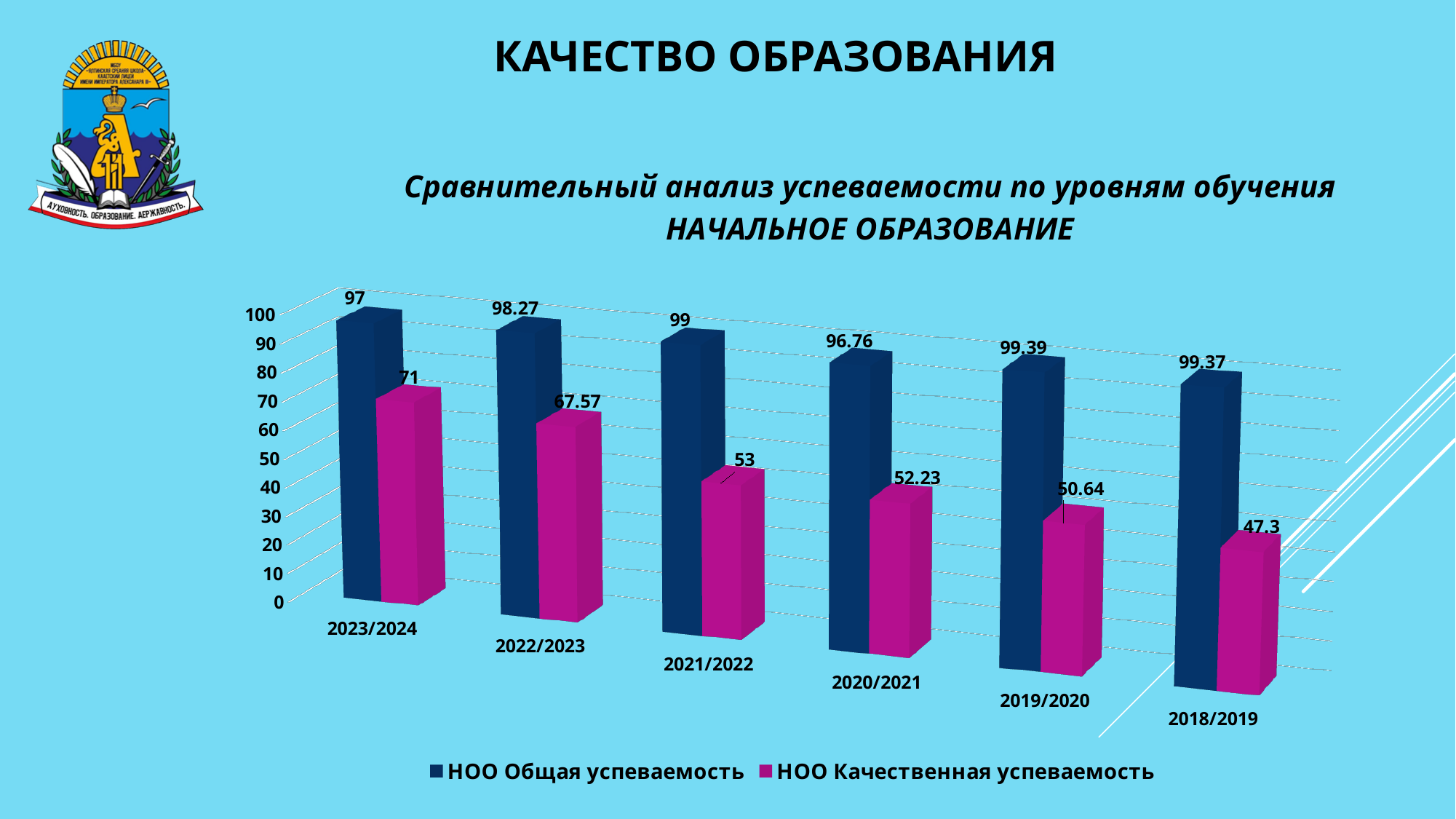
Which year has the highest value for НОО Качественная успеваемость? 2023/2024 How many series does the legend list? 2 What is the value of НОО Общая успеваемость for 2020/2021? 96.76 What is the difference between НОО Общая успеваемость and НОО Качественная успеваемость in 2023/2024? 26 What is the value of НОО Качественная успеваемость for 2022/2023? 67.57 What kind of chart is shown on the slide? Bar chart What is the value of НОО Качественная успеваемость for 2018/2019? 47.3 Does НОО Качественная успеваемость rise or fall from 2023/2024 to 2018/2019 along the x axis? Fall What is the value of НОО Общая успеваемость for 2021/2022? 99 How many academic years are shown on the x axis? 6 Which year has the lowest value for НОО Общая успеваемость? 2020/2021 Which is larger: НОО Качественная успеваемость in 2021/2022 or in 2019/2020? 2021/2022